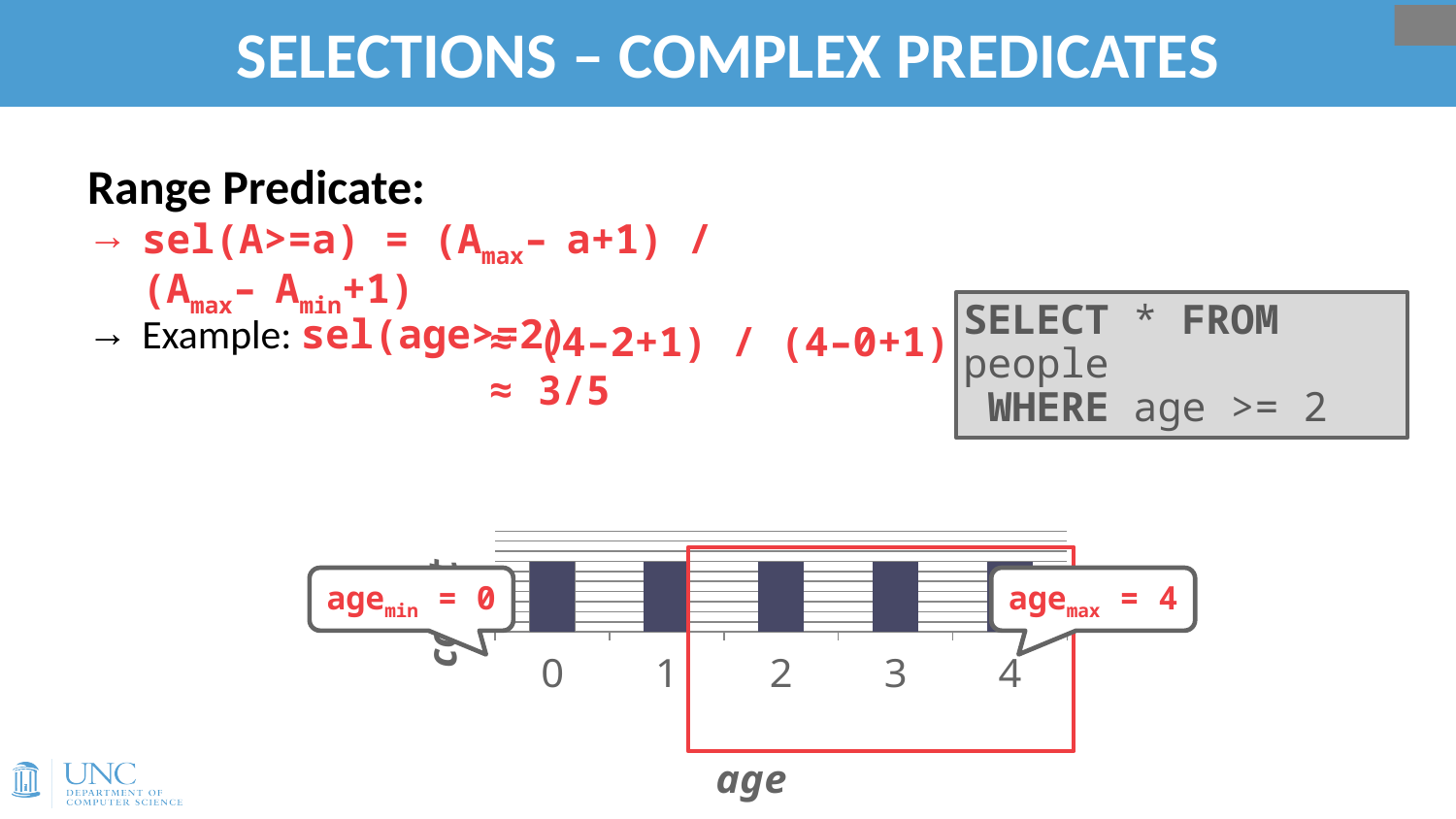
How many bars on the chart fall inside the red box? 3 What is the largest age category shown on the x axis of the chart? 4 How many categories are shown along the x axis of the chart? 5 What is the smallest age category shown on the x axis of the chart? 0 What is the label of the x axis of the chart? age Do the bar heights rise, fall, or stay the same as age increases along the x axis? stay the same What kind of chart is shown on the slide? bar chart Which age categories are enclosed by the red box on the chart? 2, 3 and 4